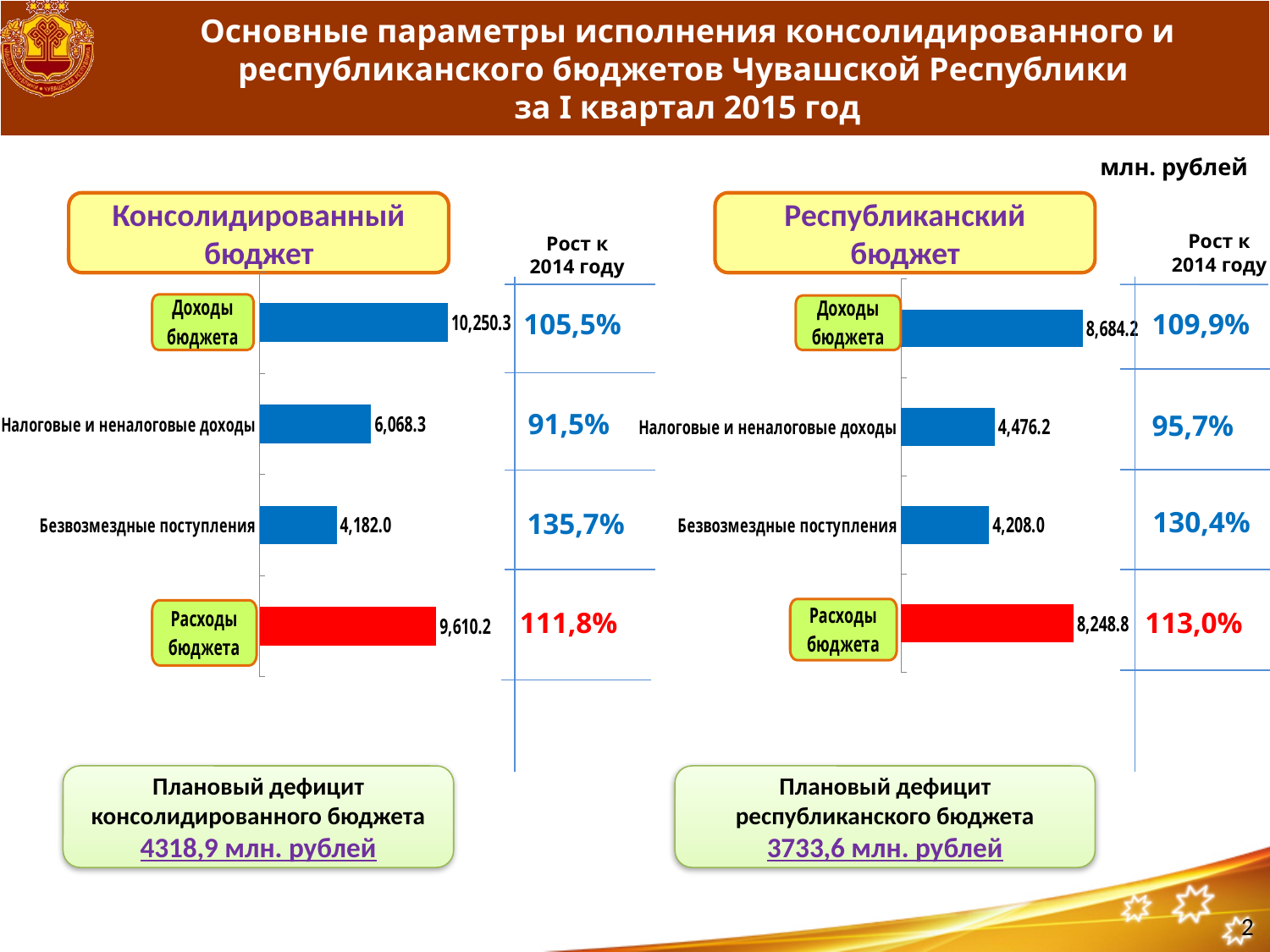
In the 'Консолидированный бюджет' chart, what is the difference between 'Доходы бюджета' and 'Расходы бюджета'? 640.1 In the 'Консолидированный бюджет' chart, what colour is the bar for 'Расходы бюджета'? Red In the 'Республиканский бюджет' chart, which is larger: 'Налоговые и неналоговые доходы' or 'Безвозмездные поступления'? Налоговые и неналоговые доходы How many categories are shown in the 'Консолидированный бюджет' chart? 4 In the 'Республиканский бюджет' chart, what is the value for 'Налоговые и неналоговые доходы'? 4,476.2 In the 'Консолидированный бюджет' chart, what is the value for 'Безвозмездные поступления'? 4,182.0 In the 'Консолидированный бюджет' chart, what is the value for 'Доходы бюджета'? 10,250.3 What type of chart is the 'Республиканский бюджет' chart? Bar chart In the 'Республиканский бюджет' chart, what is the value for 'Расходы бюджета'? 8,248.8 In the 'Республиканский бюджет' chart, which category has the lowest value? Безвозмездные поступления In the 'Республиканский бюджет' chart, what is the difference between 'Доходы бюджета' and 'Расходы бюджета'? 435.4 In the 'Консолидированный бюджет' chart, which category has the highest value? Доходы бюджета